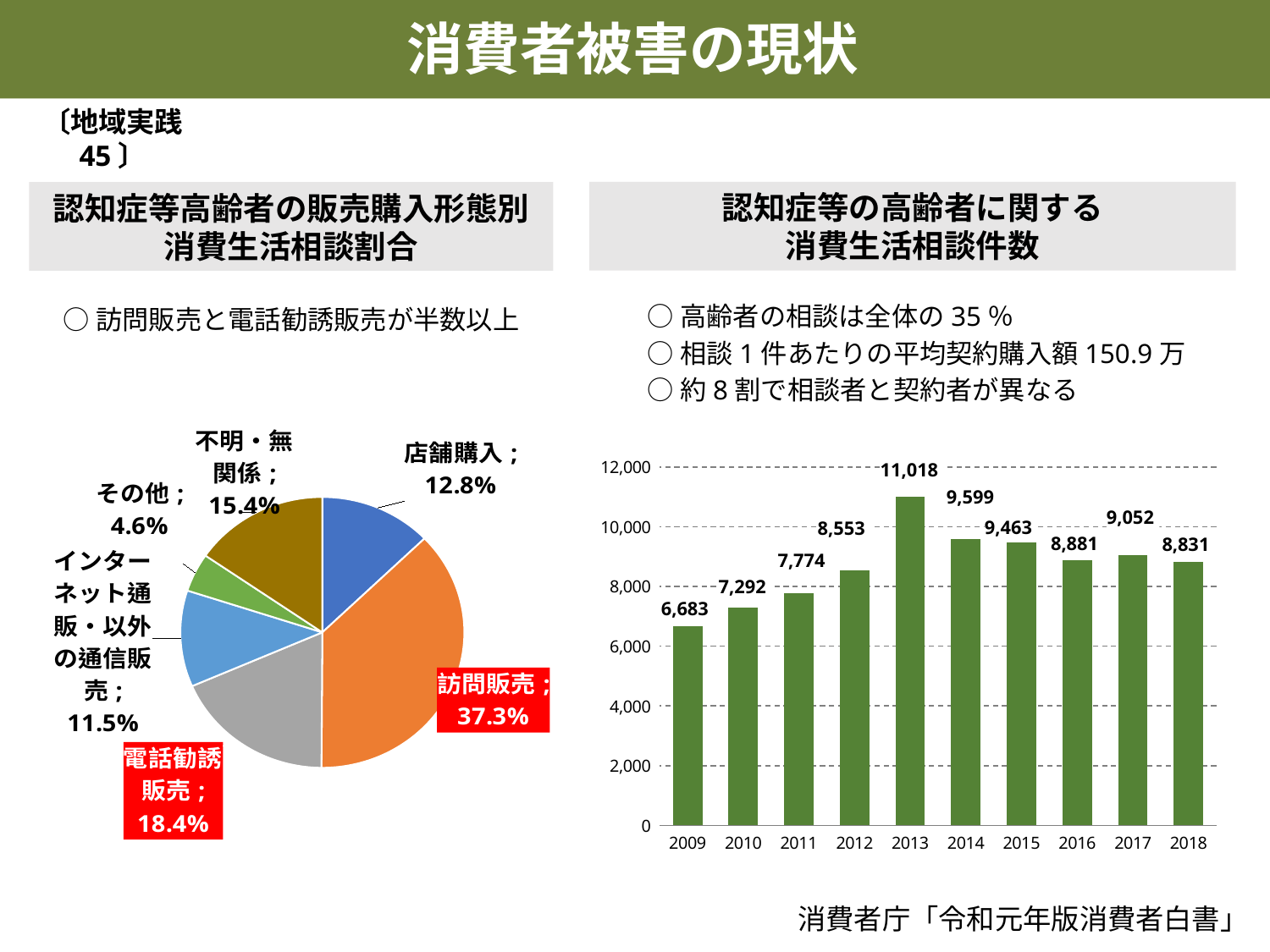
右の棒グラフで、相談件数が最も少ない年はどれですか？ 2009 右の棒グラフで、2009年から2013年にかけて相談件数は増加していますか、減少していますか？ 増加 左の円グラフで、最も割合が大きい販売購入形態はどれですか？ 訪問販売 左の円グラフで、電話勧誘販売の割合はいくらですか？ 18.4% 右の棒グラフで、2013年の相談件数はいくらですか？ 11,018 右の棒グラフで、2018年と2009年の相談件数の差はいくらですか？ 2,148 右の棒グラフで、2014年と2017年では、どちらの相談件数が多いですか？ 2014 左の円グラフ「認知症等高齢者の販売購入形態別消費生活相談割合」で、訪問販売の割合はいくらですか？ 37.3% 左の円グラフで、訪問販売と電話勧誘販売の割合の合計はいくらですか？ 55.7% 左の円グラフには、いくつの区分がありますか？ 6 右のグラフ「認知症等の高齢者に関する消費生活相談件数」は、どのような種類のグラフですか？ 棒グラフ 左の円グラフで、最も割合が小さい販売購入形態はどれですか？ その他